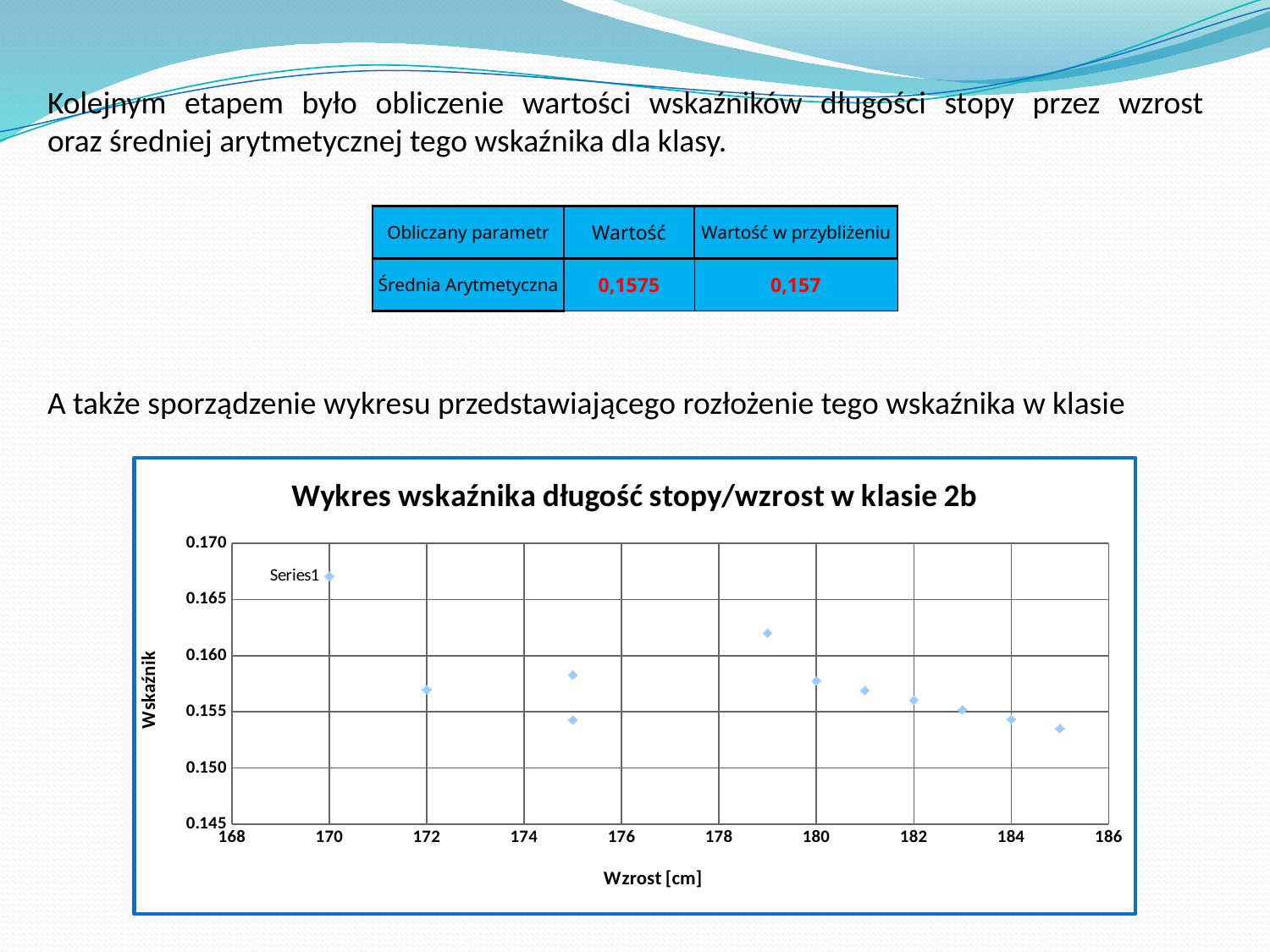
Is the value for the point at 170 cm greater or less than 0.165? greater What is the title of the chart? Wykres wskaźnika długość stopy/wzrost w klasie 2b Is the value for the point at 172 cm greater or less than 0.160? less How many data points are plotted in the chart? 11 Which x value has the highest plotted indicator value? 170 What kind of chart is shown on the slide? scatter chart How many series does the chart show? 1 Which has the larger indicator value, the point at 179 cm or the point at 183 cm? 179 cm What is the label of the x axis of the chart? Wzrost [cm] Is the value for the point at 185 cm greater or less than 0.155? less Which x value has the lowest plotted indicator value? 185